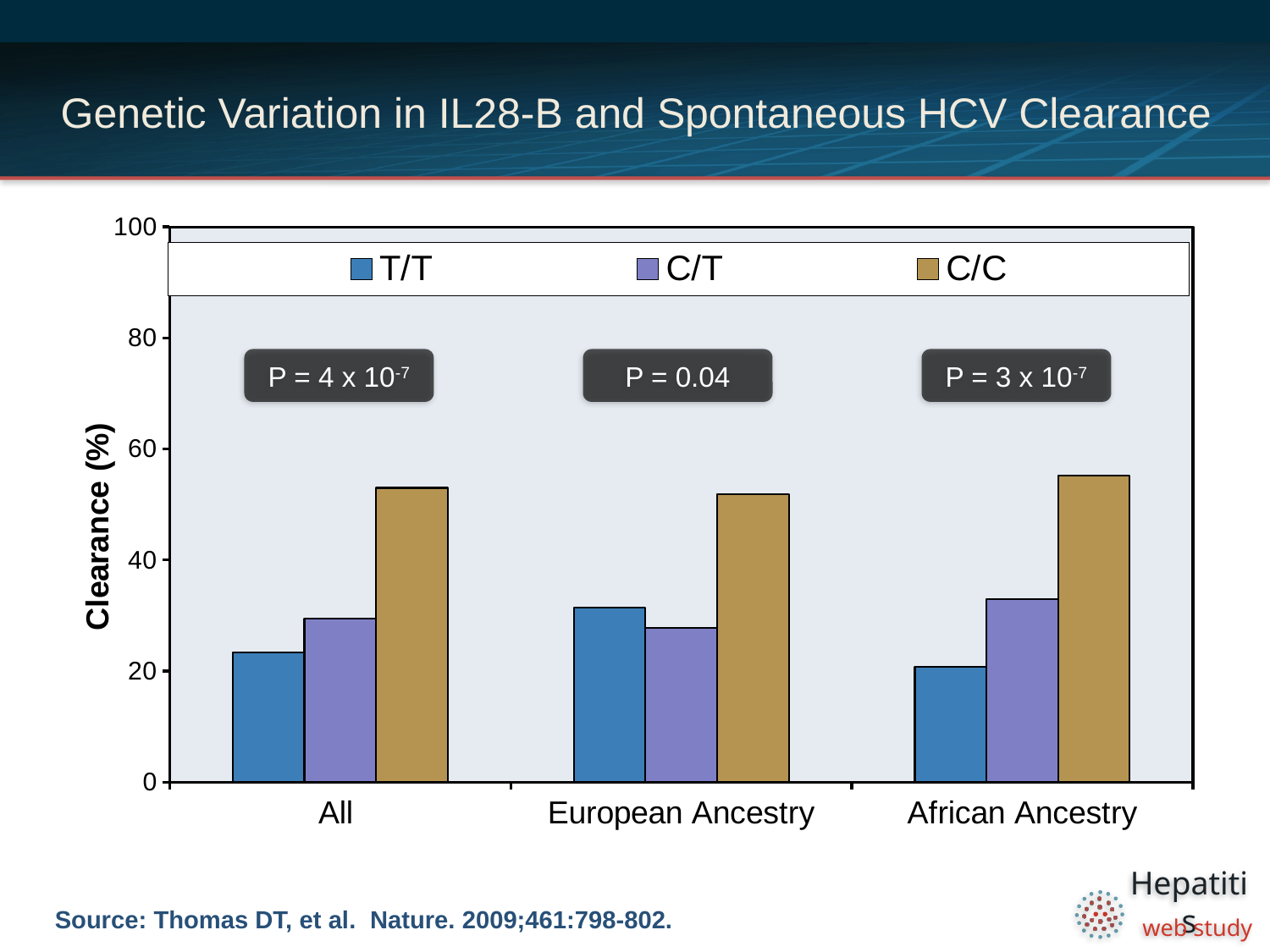
In the European Ancestry group, which is larger: the clearance for C/C or for C/T? C/C How many series does the legend list? 3 In the African Ancestry group, which is larger: the clearance for C/T or for T/T? C/T Which genotype has the lowest clearance in the All group? T/T How many ancestry groups (categories) are shown on the x axis? 3 What is the label of the y axis? Clearance (%) Which genotype has the lowest clearance in the African Ancestry group? T/T Is the clearance for T/T in the African Ancestry group greater or less than 40? less What kind of chart is shown on the slide? bar chart Is the clearance for C/C in the All group greater or less than 40? greater What P value is shown for the European Ancestry group? P = 0.04 Which genotype has the highest clearance in the All group? C/C